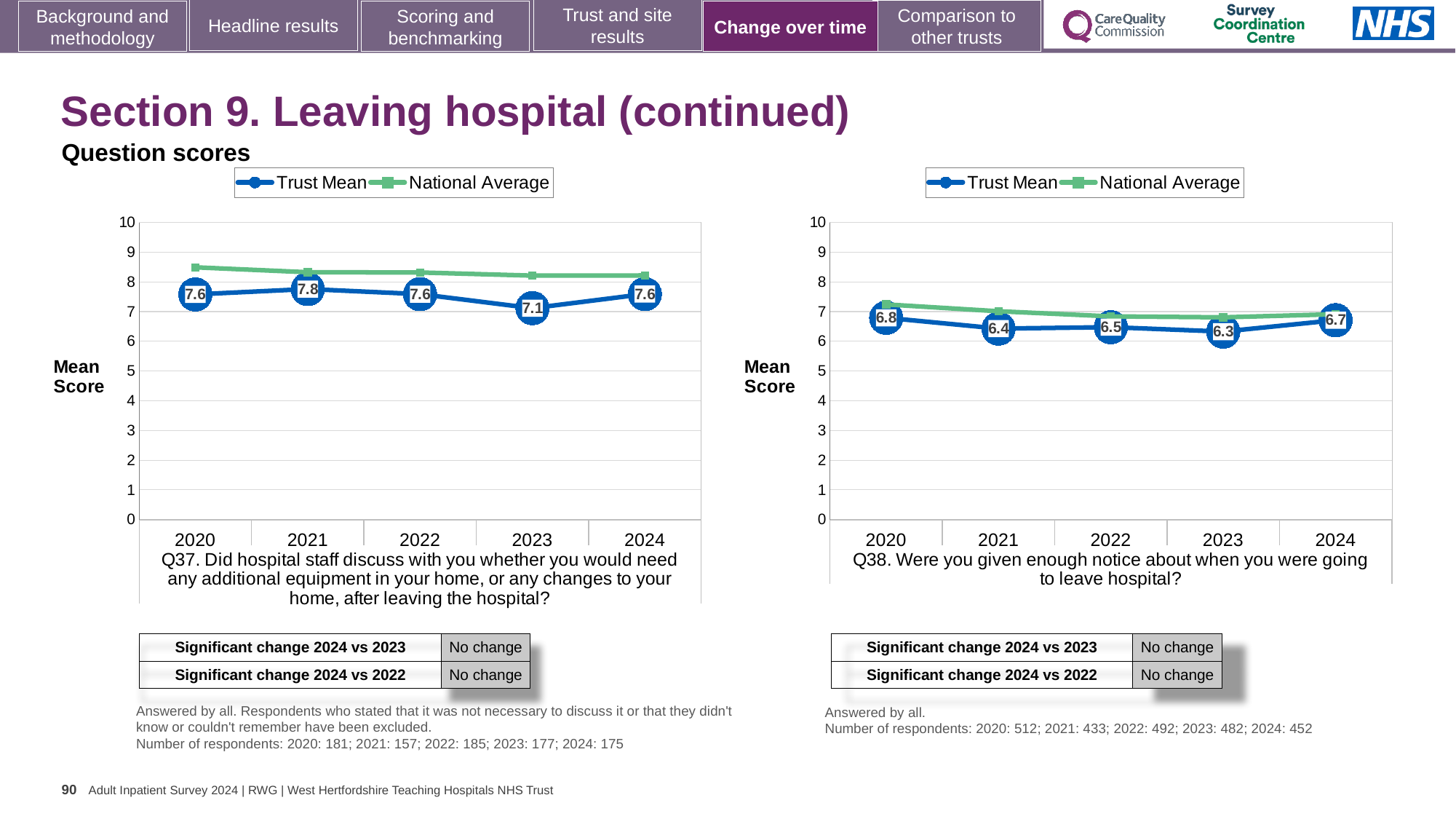
In the Q37 chart on the left, what is the Trust Mean score for 2021? 7.8 In the Q38 chart on the right, what is the Trust Mean score for 2020? 6.8 How many years are plotted on the x axis of the Q38 chart on the right? 5 How many series does the legend of the Q37 chart on the left list? 2 In the Q37 chart on the left, what is the Trust Mean score for 2023? 7.1 In the Q37 chart on the left, is the National Average for 2020 greater or less than 8? greater In the Q38 chart on the right, which is larger, the Trust Mean score for 2021 or for 2024? 2024 In the Q38 chart on the right, what is the Trust Mean score for 2024? 6.7 In the Q38 chart on the right, which year has the highest Trust Mean score? 2020 What kind of chart is the Q38 chart on the right? Line chart In the Q37 chart on the left, what is the difference between the Trust Mean scores for 2021 and 2023? 0.7 In the Q37 chart on the left, which year has the lowest Trust Mean score? 2023